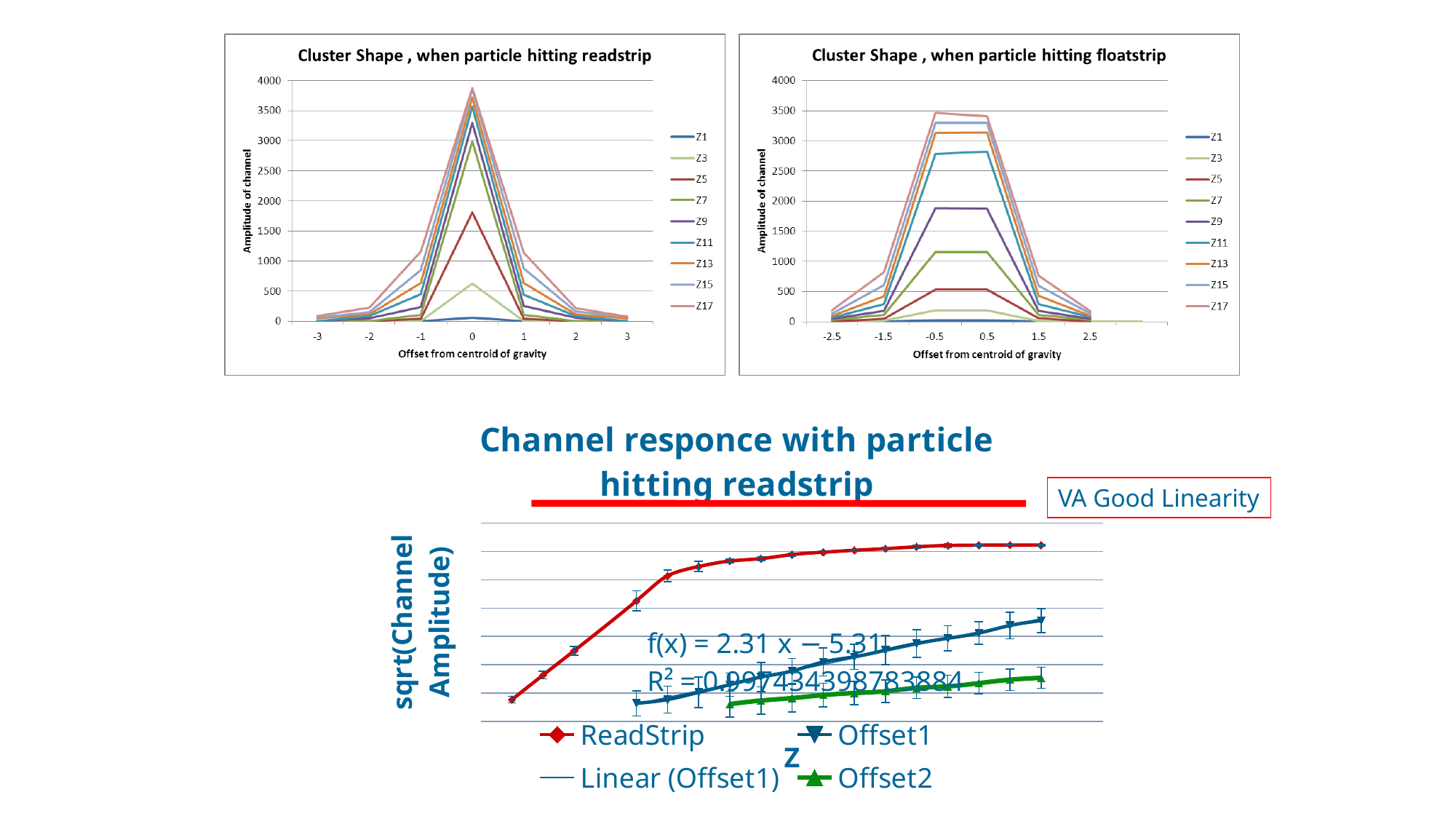
In the 'Cluster Shape , when particle hitting readstrip' chart, how many offset tick values are shown on the x axis? 7 In the 'Cluster Shape , when particle hitting readstrip' chart, which series has the lowest amplitude at offset 0? Z1 In the 'Cluster Shape , when particle hitting floatstrip' chart, is the value for Z11 at offset -0.5 greater or less than 3000? less In the 'Cluster Shape , when particle hitting floatstrip' chart, which series is higher at offset -0.5, Z13 or Z7? Z13 In the 'Cluster Shape , when particle hitting readstrip' chart, is the value for Z5 at offset 0 greater or less than 1500? greater In the 'Channel responce with particle hitting readstrip' chart, what is the R² value shown for the linear fit? 0.997434398783884 How many entries does the legend list in the 'Channel responce with particle hitting readstrip' chart? 4 What type of chart is the 'Cluster Shape , when particle hitting readstrip' chart? line chart How many series does the legend list in the 'Cluster Shape , when particle hitting readstrip' chart? 9 In the 'Cluster Shape , when particle hitting readstrip' chart, is the value for Z17 at offset 0 greater or less than 3500? greater In the 'Cluster Shape , when particle hitting readstrip' chart, which series has the highest peak amplitude? Z17